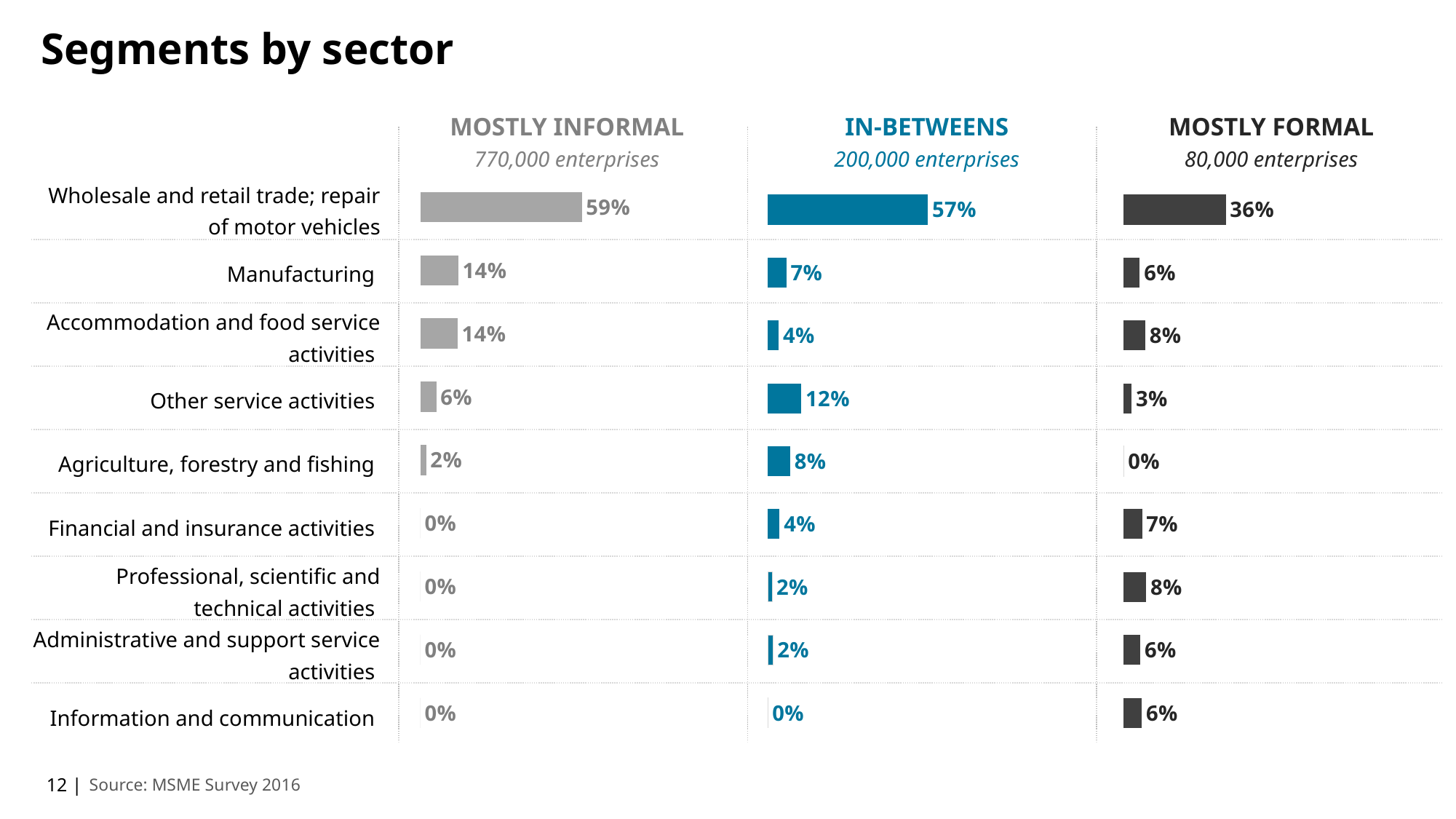
In the Mostly Informal chart, what is the value for Wholesale and retail trade; repair of motor vehicles? 59% For Agriculture, forestry and fishing, which is larger: the In-Betweens value or the Mostly Informal value? In-Betweens What is the difference between the Mostly Informal and Mostly Formal values for Wholesale and retail trade; repair of motor vehicles? 23% In the In-Betweens chart, what is the value for Other service activities? 12% For Manufacturing, which is larger: the Mostly Informal value or the In-Betweens value? Mostly Informal How many sectors are listed in the charts? 9 How many enterprises does the In-Betweens segment represent, according to the chart header? 200,000 enterprises In the Mostly Formal chart, what is the value for Accommodation and food service activities? 8% In the In-Betweens chart, which sector has the highest value? Wholesale and retail trade; repair of motor vehicles What is the difference between the In-Betweens and Mostly Formal values for Other service activities? 9% In the Mostly Formal chart, which sector has the lowest value? Agriculture, forestry and fishing What kind of chart is used on this slide? Bar chart